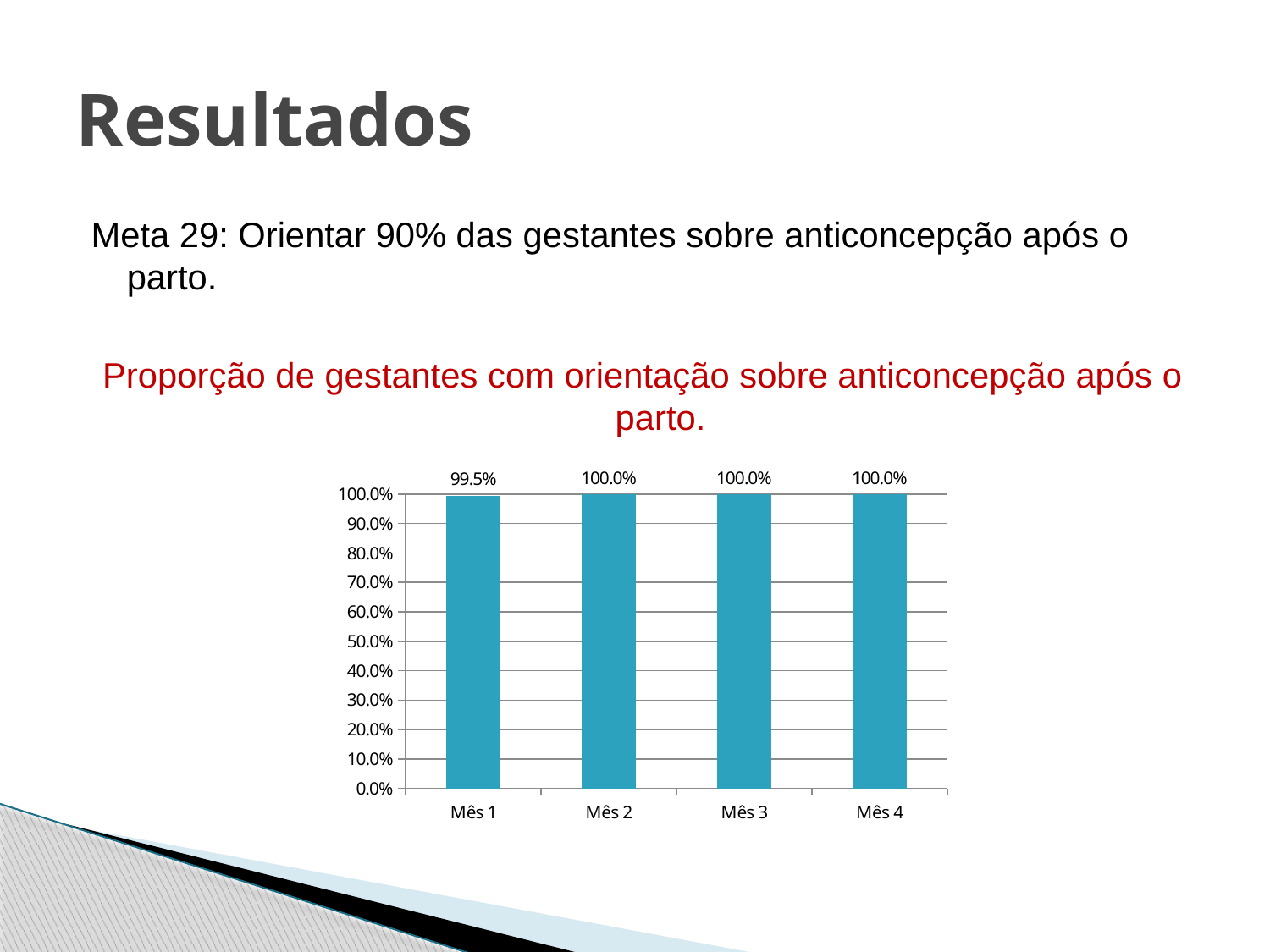
What kind of chart is shown on the slide? bar chart How many months have a value of 100.0%? 3 What is the value for Mês 4? 100.0% Which month has the lowest value? Mês 1 Do the values rise or fall from Mês 1 to Mês 2? rise What is the title of the chart? Proporção de gestantes com orientação sobre anticoncepção após o parto. What is the difference between the values for Mês 2 and Mês 1? 0.5% Is the value for Mês 3 greater or less than 90.0%? greater What is the value for Mês 2? 100.0% What is the value for Mês 1? 99.5% How many months are shown on the x axis? 4 What is the highest value shown on the y axis? 100.0%